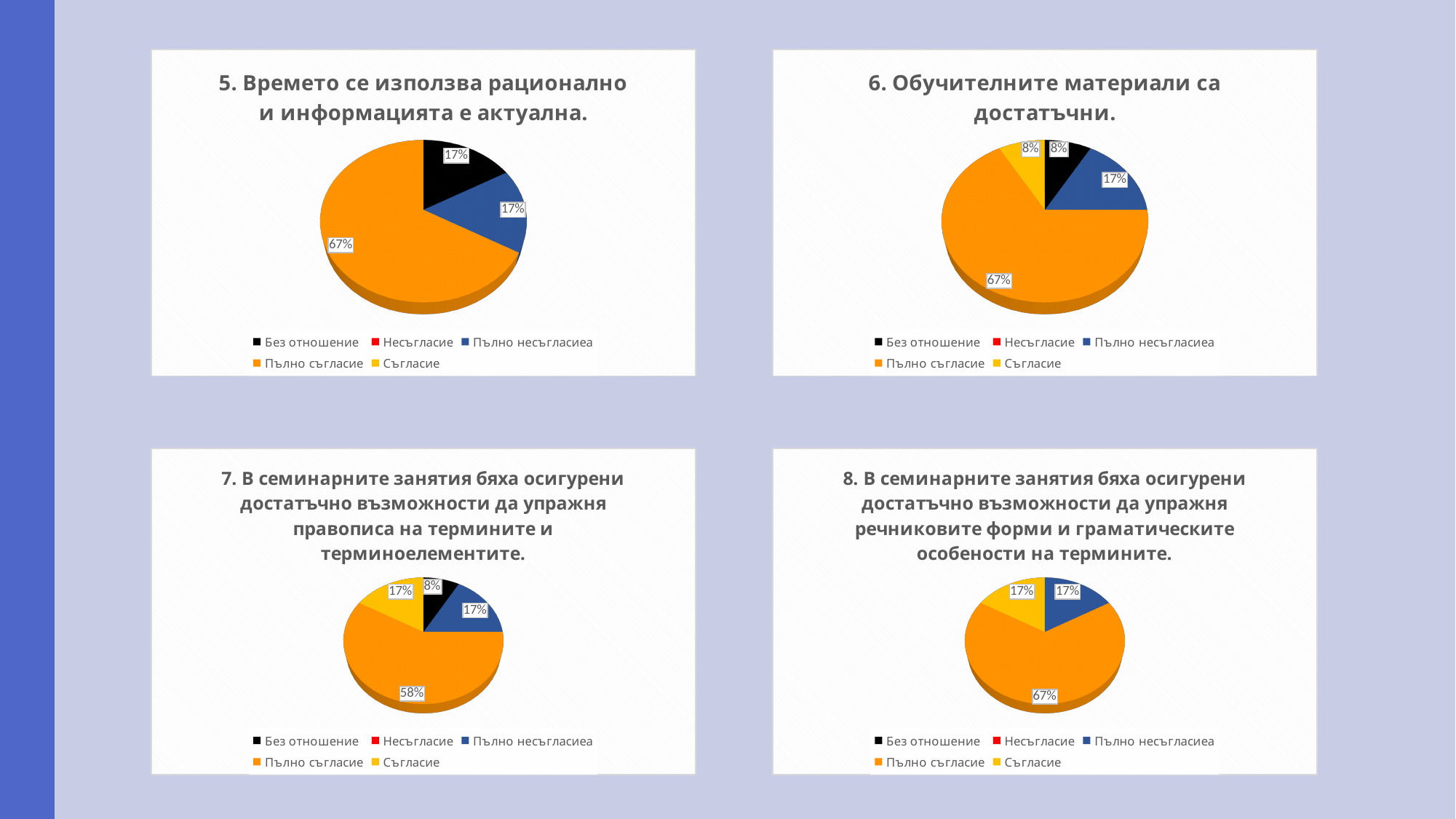
How many entries does the legend of the top-right chart (6. Обучителните материали са достатъчни.) list? 5 In the top-left chart (5. Времето се използва рационално и информацията е актуална.), what is the value for Без отношение? 17% In the bottom-left chart (7. В семинарните занятия бяха осигурени достатъчно възможности да упражня правописа на термините и терминоелементите.), which category has the smallest slice? Без отношение In the top-right chart (6. Обучителните материали са достатъчни.), what is the value for Съгласие? 8% In the bottom-left chart (7. В семинарните занятия бяха осигурени достатъчно възможности да упражня правописа на термините и терминоелементите.), what is the difference between Пълно съгласие and Съгласие? 41% In the bottom-left chart (7. В семинарните занятия бяха осигурени достатъчно възможности да упражня правописа на термините и терминоелементите.), what share does Пълно съгласие have? 58% In the bottom-right chart (8. В семинарните занятия бяха осигурени достатъчно възможности да упражня речниковите форми и граматическите особености на термините.), what is the value for Пълно несъгласиеа? 17% In the top-left chart (5. Времето се използва рационално и информацията е актуална.), what share does Пълно съгласие have? 67% In the bottom-right chart (8. В семинарните занятия бяха осигурени достатъчно възможности да упражня речниковите форми и граматическите особености на термините.), which is larger, Пълно съгласие or Съгласие? Пълно съгласие In the top-right chart (6. Обучителните материали са достатъчни.), which category has the largest slice? Пълно съгласие In the top-left chart (5. Времето се използва рационално и информацията е актуална.), what colour is the Пълно съгласие slice? Orange What kind of chart is the top-left chart (5. Времето се използва рационално и информацията е актуална.)? Pie chart